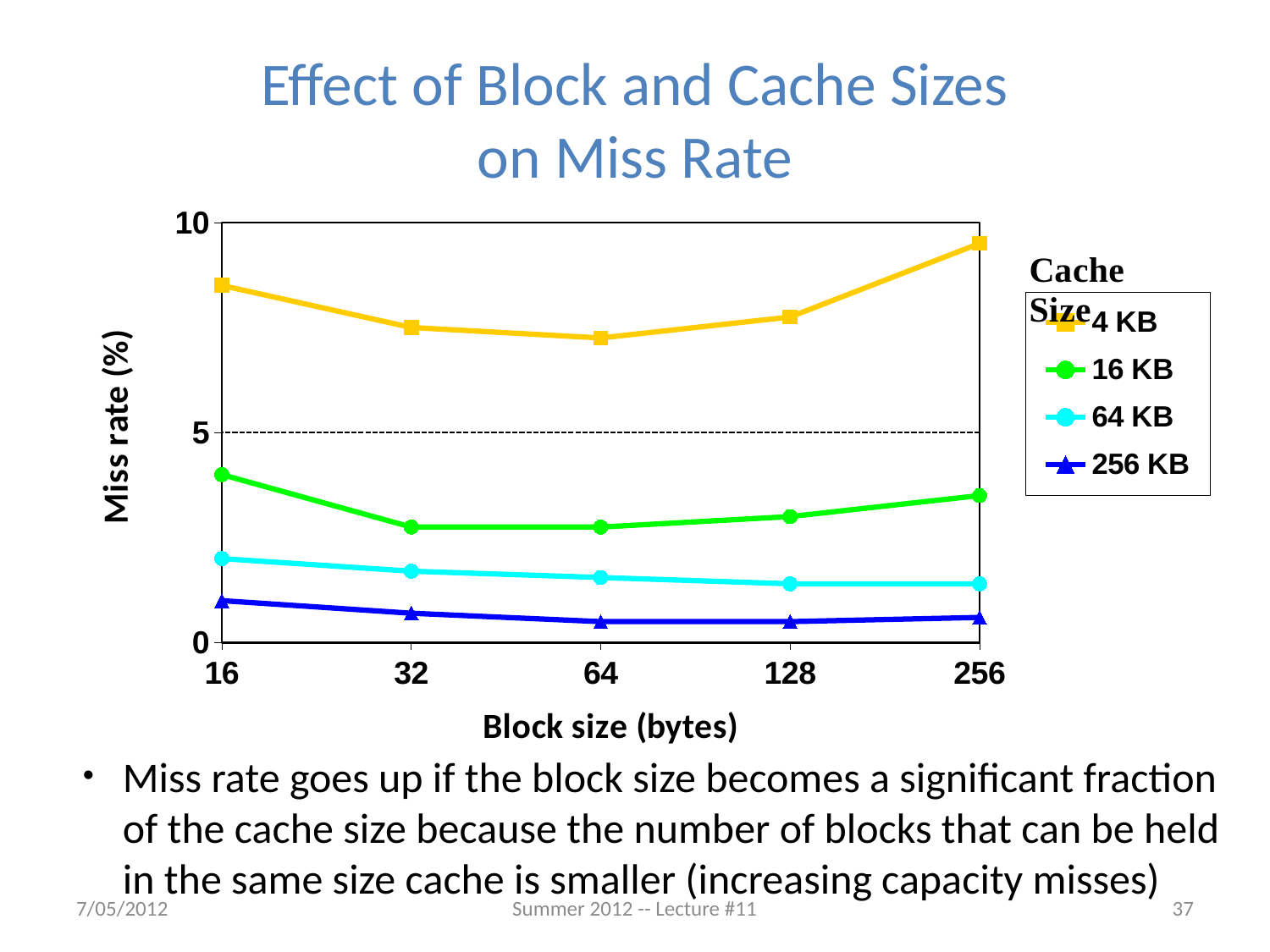
What is the label of the x axis? Block size (bytes) Is the miss rate for the 4 KB cache at a block size of 64 bytes greater or less than 5? greater What is the label of the y axis? Miss rate (%) How many series does the legend list? 4 Is the miss rate for the 16 KB cache at a block size of 16 bytes greater or less than 5? less How many block sizes are plotted along the x axis? 5 Which is larger: the miss rate for the 16 KB cache or the 64 KB cache at a block size of 128 bytes? 16 KB Which cache size has the highest miss rate at a block size of 256 bytes? 4 KB Which cache size has the lowest miss rate at a block size of 16 bytes? 256 KB What kind of chart is shown on the slide? line chart Does the miss rate for the 64 KB cache rise or fall as block size increases from 16 to 256 bytes? fall Is the miss rate for the 256 KB cache at a block size of 256 bytes greater or less than 5? less